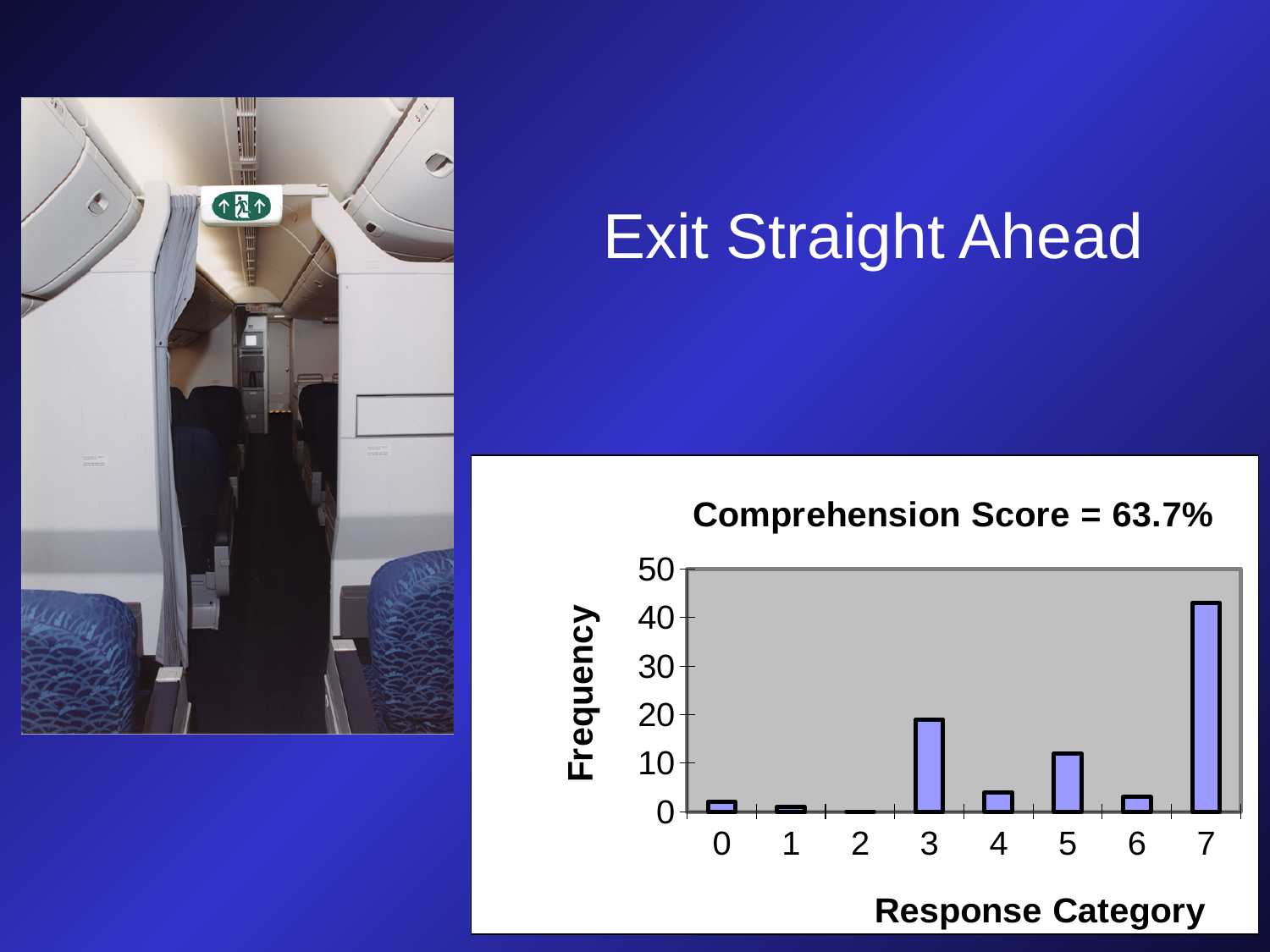
Is the frequency for response category 7 greater or less than 40? greater Which response category has the highest frequency? 7 Which has the higher frequency, response category 3 or response category 5? 3 What kind of chart is shown on the slide? bar chart Which has the higher frequency, response category 7 or response category 3? 7 What is the title of the chart? Comprehension Score = 63.7% Is the frequency for response category 6 greater or less than 10? less Is the frequency for response category 5 greater or less than 10? greater How many response categories are shown on the x axis of the chart? 8 What is the label of the y axis of the chart? Frequency